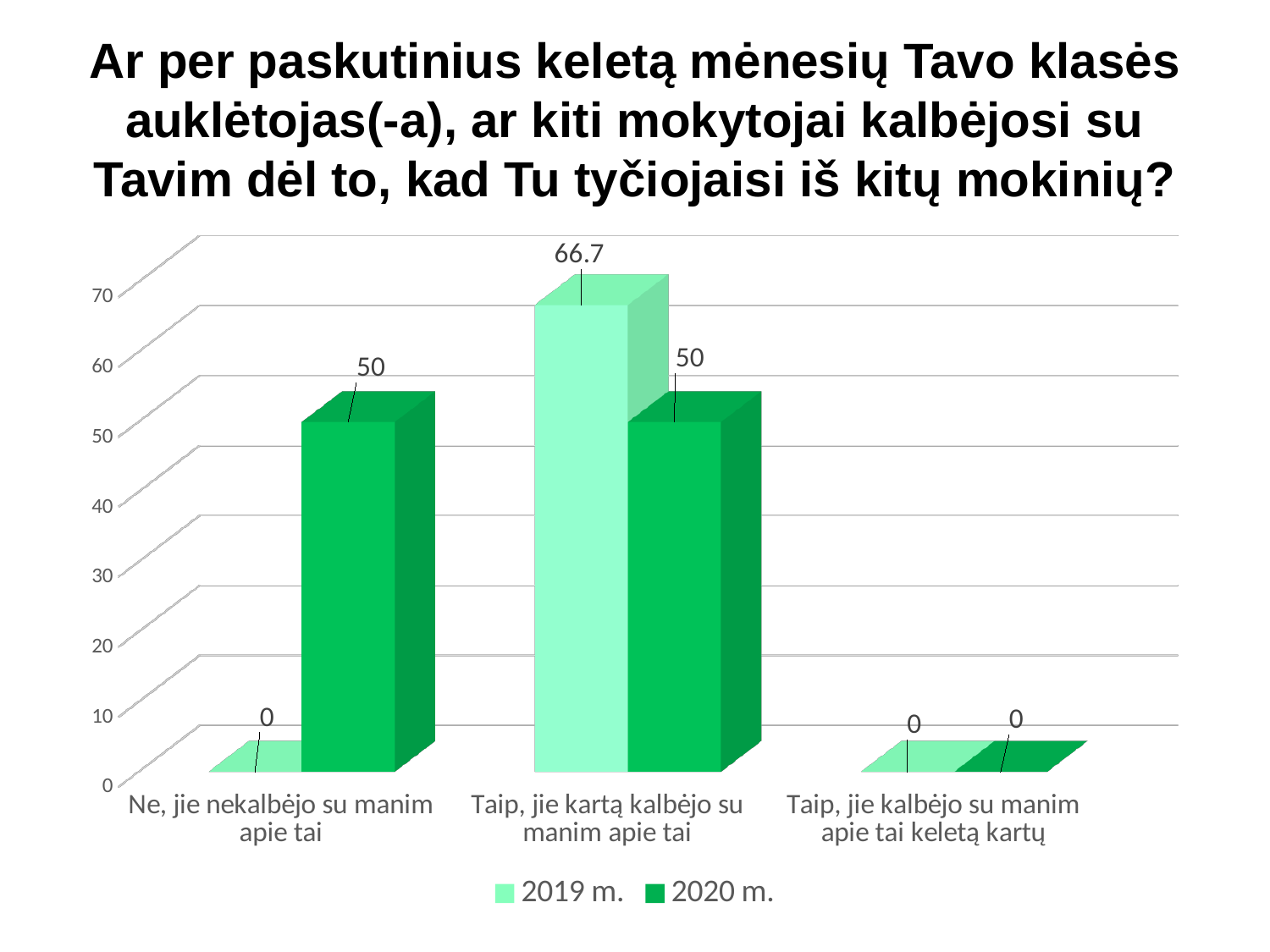
In the category "Ne, jie nekalbėjo su manim apie tai", which series has the larger value, 2019 m. or 2020 m.? 2020 m. Which category has the highest value for 2019 m.? Taip, jie kartą kalbėjo su manim apie tai Which category has the lowest value for 2020 m.? Taip, jie kalbėjo su manim apie tai keletą kartų Is the 2019 m. value for "Taip, jie kartą kalbėjo su manim apie tai" greater or less than 60? greater What kind of chart is shown on the slide? bar chart What is the difference between the 2019 m. and 2020 m. values in the category "Taip, jie kartą kalbėjo su manim apie tai"? 16.7 What is the value for 2020 m. in the category "Taip, jie kalbėjo su manim apie tai keletą kartų"? 0 What is the value for 2020 m. in the category "Ne, jie nekalbėjo su manim apie tai"? 50 How many categories are shown on the x axis? 3 How many series does the legend list? 2 What is the value for 2019 m. in the category "Ne, jie nekalbėjo su manim apie tai"? 0 What is the value for 2019 m. in the category "Taip, jie kartą kalbėjo su manim apie tai"? 66.7